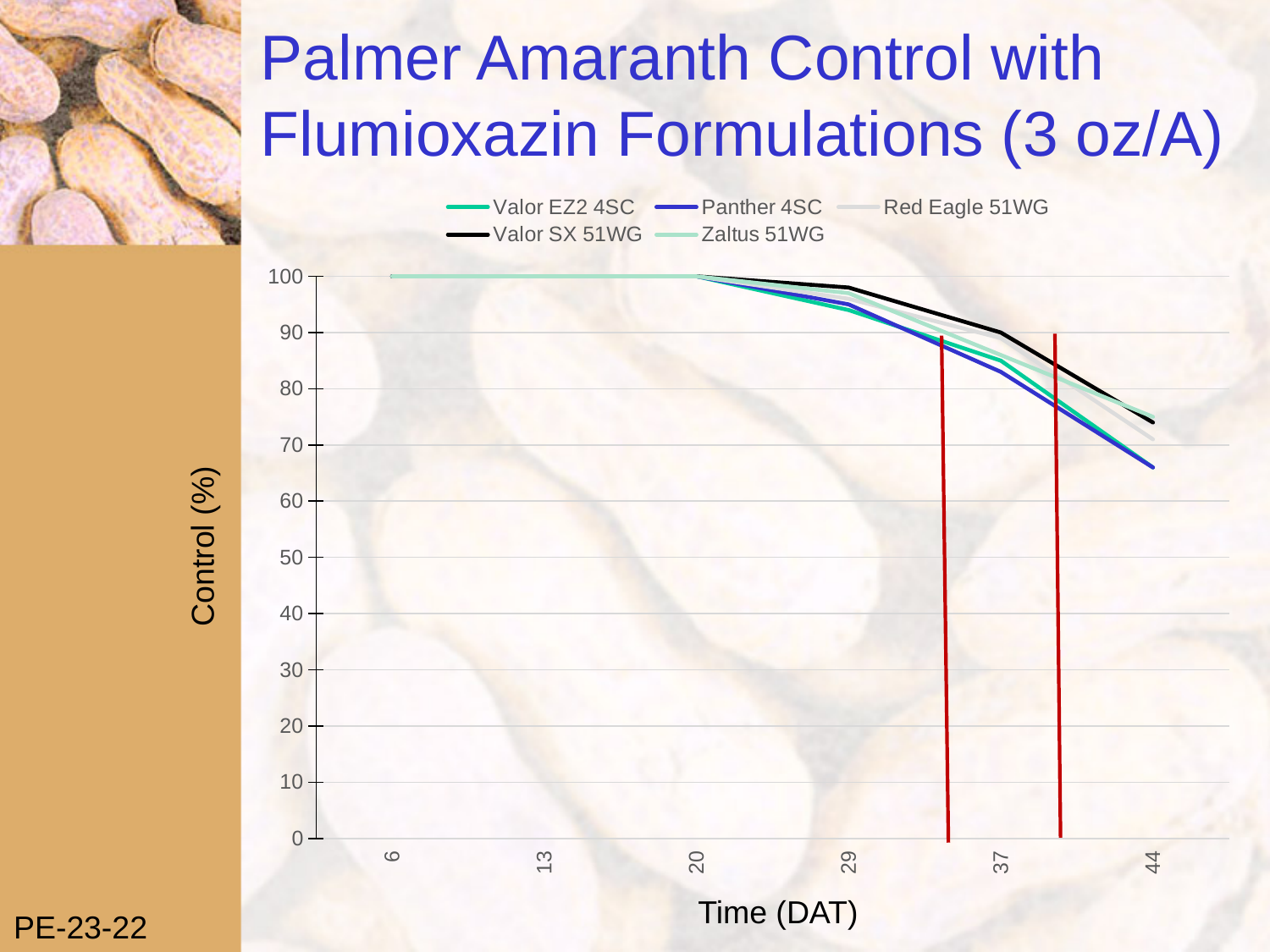
At 44 DAT, which is larger: the control for Valor SX 51WG or for Panther 4SC? Valor SX 51WG Is the control for Valor SX 51WG at 44 DAT greater or less than 70? greater What kind of chart is shown on the slide? line chart How many time points are labelled on the x axis? 6 Do the control values rise or fall as time (DAT) increases from 20 to 44? fall Is the control for Panther 4SC at 44 DAT greater or less than 70? less Which formulation has the highest control at 37 DAT? Valor SX 51WG What is the label of the y axis? Control (%) What is the control (%) for Panther 4SC at 20 DAT? 100 Is the control for Valor SX 51WG at 37 DAT greater or less than 80? greater How many series does the legend list? 5 What is the control (%) for Valor SX 51WG at 6 DAT? 100